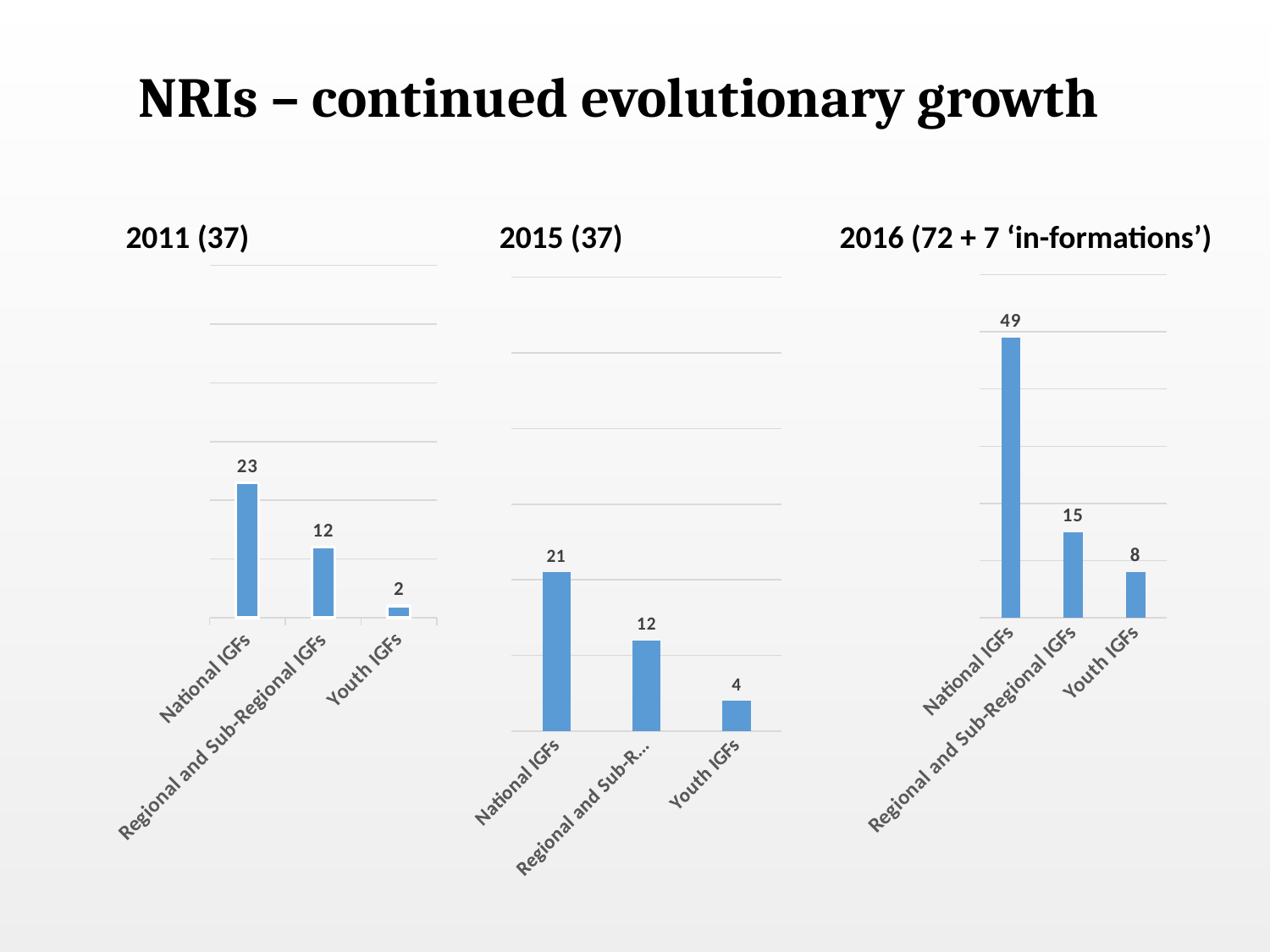
In the 2016 chart, what is the difference between National IGFs and Regional and Sub-Regional IGFs? 34 In the 2016 chart, what is the value for Youth IGFs? 8 How many categories does the 2016 chart show? 3 In the 2011 (37) chart, what is the value for Youth IGFs? 2 Which is larger: National IGFs in the 2011 (37) chart or National IGFs in the 2015 (37) chart? 2011 (37) In the 2016 chart, what is the value for National IGFs? 49 In the 2015 (37) chart, which category has the lowest value? Youth IGFs In the 2011 (37) chart, what is the value for National IGFs? 23 In the 2016 chart, which category has the highest value? National IGFs In the 2015 (37) chart, what is the value for Regional and Sub-Regional IGFs? 12 In the 2011 (37) chart, what is the difference between National IGFs and Regional and Sub-Regional IGFs? 11 What kind of chart is the 2015 (37) chart? Bar chart